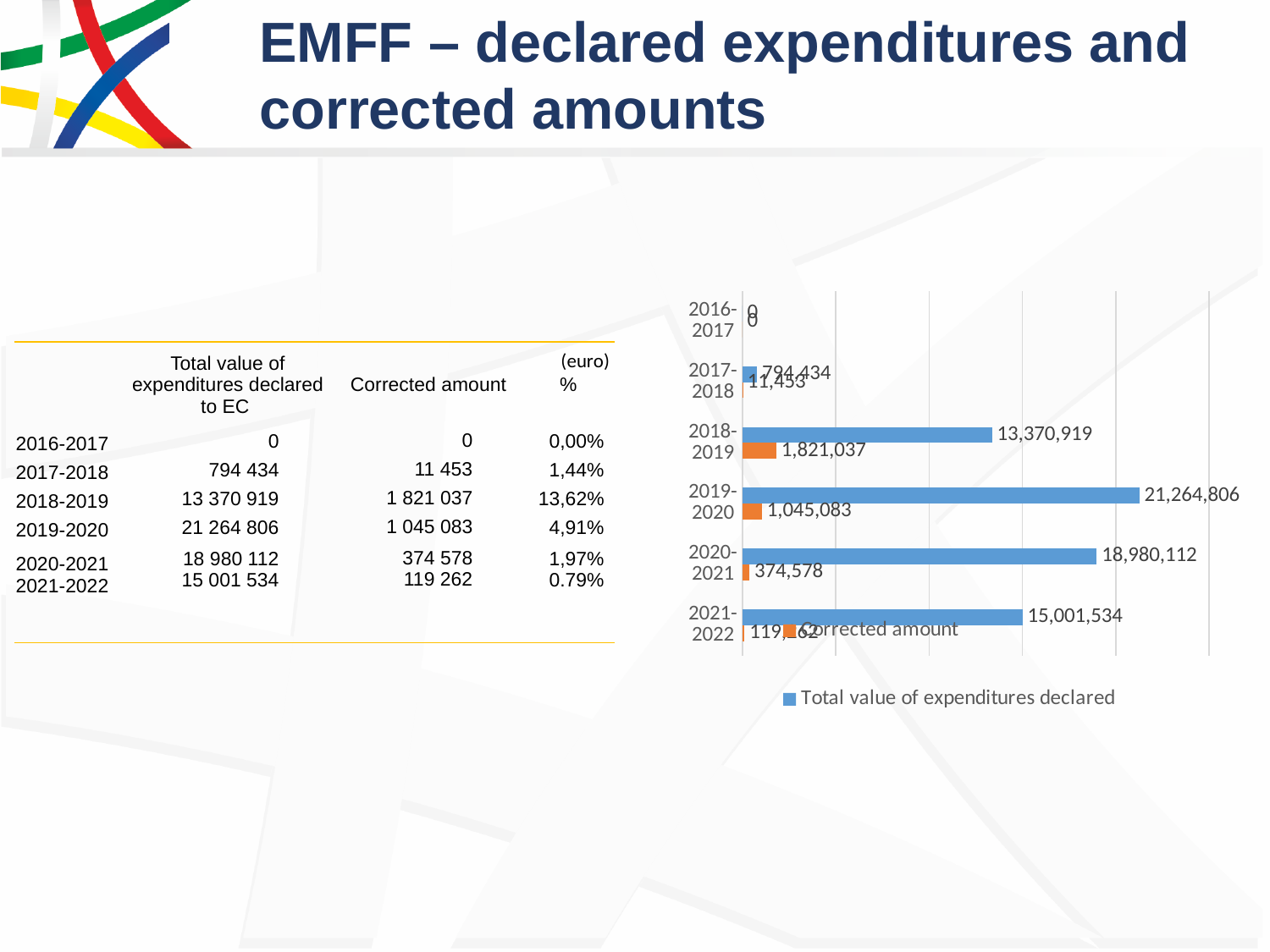
Which is larger: the total value of expenditures declared for 2020-2021 or for 2021-2022? 2020-2021 What colour are the bars for the Corrected amount series? orange What is the total value of expenditures declared for 2018-2019 on the chart? 13,370,919 Which period has the highest total value of expenditures declared? 2019-2020 How many series does the chart's legend list? 2 What is the difference between the total value of expenditures declared for 2019-2020 and for 2020-2021? 2,284,694 What is the corrected amount for 2020-2021 on the chart? 374,578 Which period has the highest corrected amount? 2018-2019 From 2019-2020 to 2021-2022, do the total values of expenditures declared rise or fall? fall What kind of chart is shown on the slide? bar chart What is the corrected amount for 2019-2020 on the chart? 1,045,083 How many year periods are plotted on the chart? 6